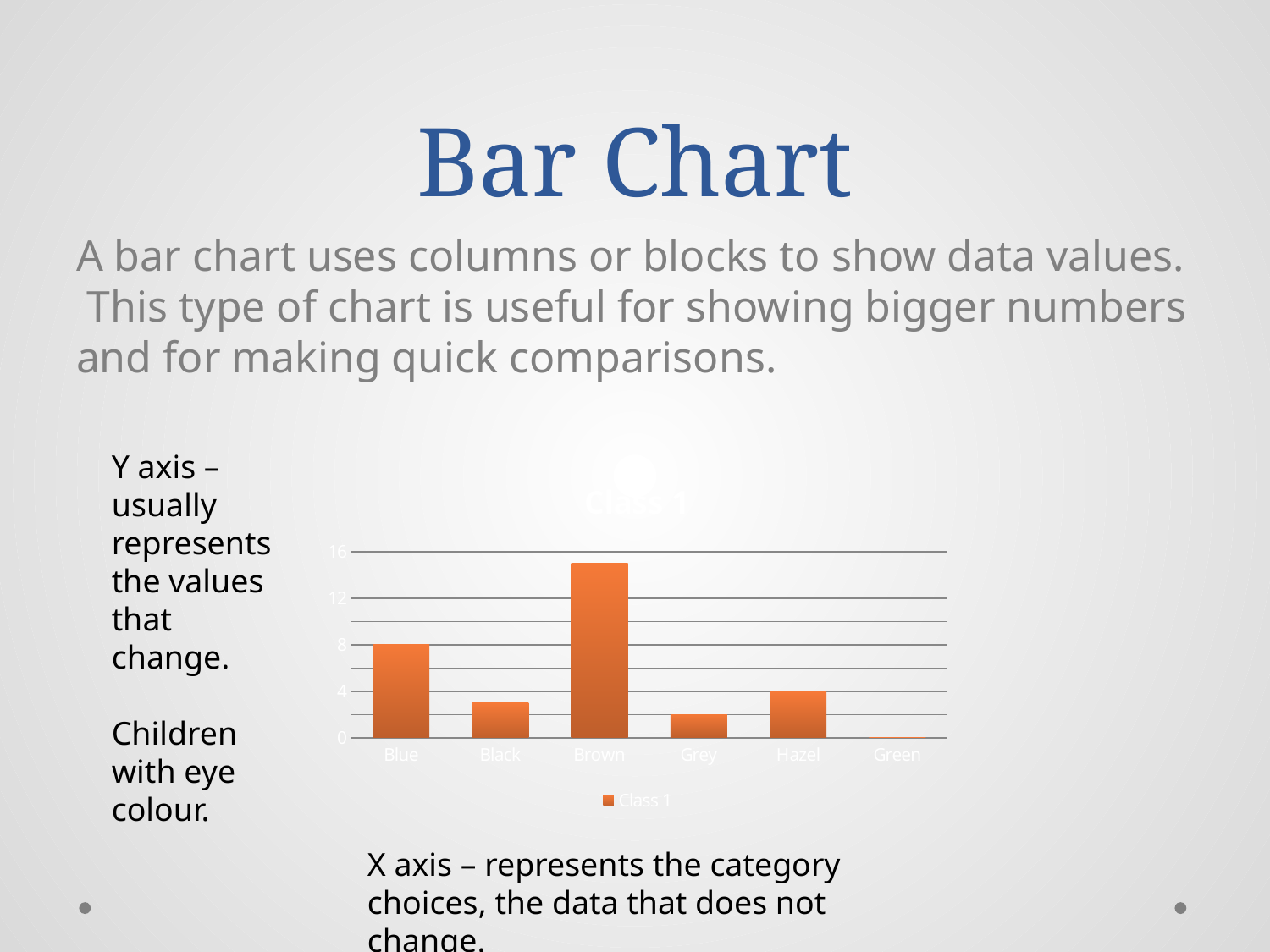
How many eye colour categories are shown on the x axis? 6 What kind of chart is shown on the slide? bar chart What is the title of the chart? Class 1 What is the difference between the values for Blue and Hazel? 4 Which is larger, the value for Blue or the value for Hazel? Blue How many series does the legend list? 1 Which eye colour has the highest value? Brown What is the value for Hazel? 4 Which eye colour has the lowest value? Green Is the value for Black greater or less than 4? less Is the value for Brown greater or less than 12? greater What is the value for Blue? 8